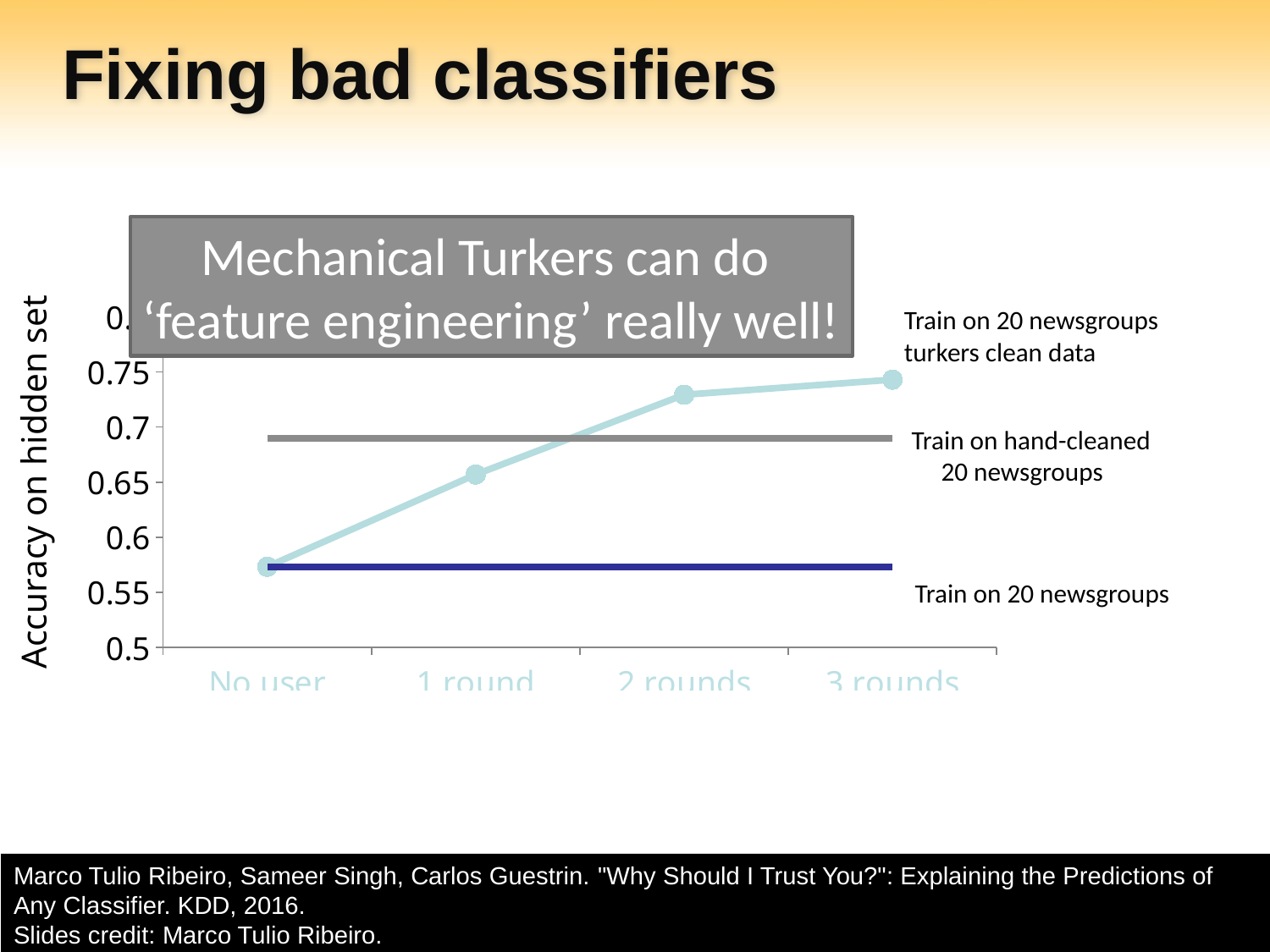
What is the label of the chart's y axis? Accuracy on hidden set Is the value of the 'Train on 20 newsgroups turkers clean data' line at '1 round' greater or less than 0.7? less Is the value of the 'Train on 20 newsgroups turkers clean data' line at '2 rounds' greater or less than 0.7? greater How many categories are shown along the x axis of the chart? 4 At 'No user', which is higher: the 'Train on 20 newsgroups turkers clean data' line or the 'Train on hand-cleaned 20 newsgroups' line? Train on hand-cleaned 20 newsgroups Is the 'Train on hand-cleaned 20 newsgroups' line greater or less than 0.65? greater What kind of chart is shown on the slide? line chart Does the 'Train on 20 newsgroups turkers clean data' line rise or fall from 'No user' to '3 rounds'? rise How many series (lines) are plotted on the chart? 3 At '3 rounds', which is higher: the 'Train on 20 newsgroups turkers clean data' line or the 'Train on hand-cleaned 20 newsgroups' line? Train on 20 newsgroups turkers clean data